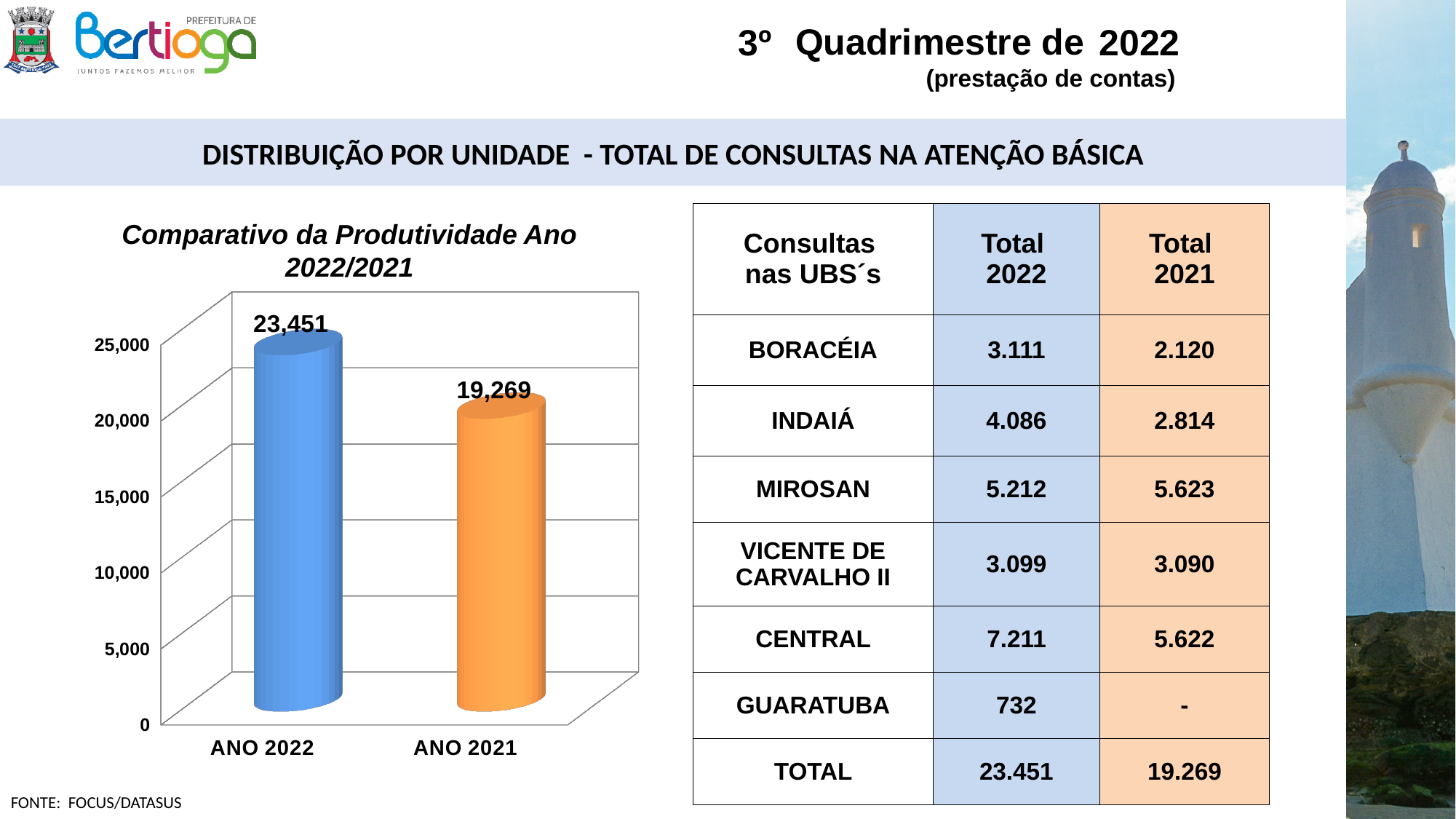
Which category has the highest value in the chart? ANO 2022 What kind of chart is shown on the slide? bar chart How many categories are shown in the chart? 2 What is the value for ANO 2022 in the chart? 23,451 Which is larger, the value for ANO 2022 or ANO 2021? ANO 2022 Which category has the lowest value in the chart? ANO 2021 Is the value for ANO 2021 greater or less than 20,000? less What is the title of the chart? Comparativo da Produtividade Ano 2022/2021 Do the values rise or fall from ANO 2022 to ANO 2021 along the x axis? fall What is the difference between the values for ANO 2022 and ANO 2021? 4,182 What is the value for ANO 2021 in the chart? 19,269 Is the value for ANO 2022 greater or less than 20,000? greater